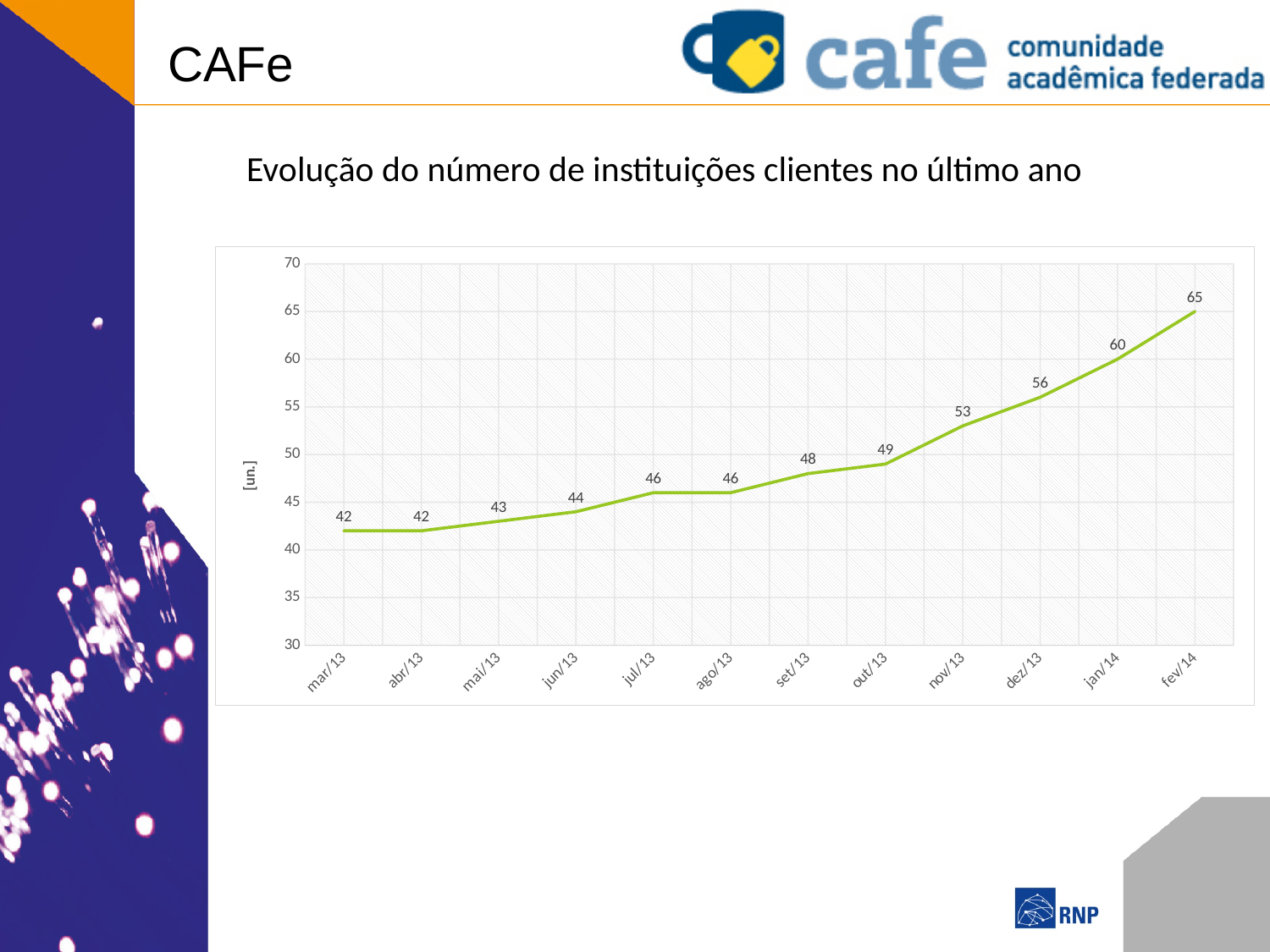
What kind of chart is shown? line chart What is the value for fev/14? 65 How many months are plotted on the x axis? 12 What is the value for mar/13? 42 Is the value for jan/14 greater or less than 55? greater What is the difference between the values for dez/13 and nov/13? 3 What is the value for set/13? 48 Which is larger, the value for jan/14 or the value for out/13? jan/14 Which month has the highest value? fev/14 What is the lowest value shown on the chart? 42 Do the values rise or fall from mar/13 to fev/14? rise What is the difference between the values for fev/14 and mar/13? 23